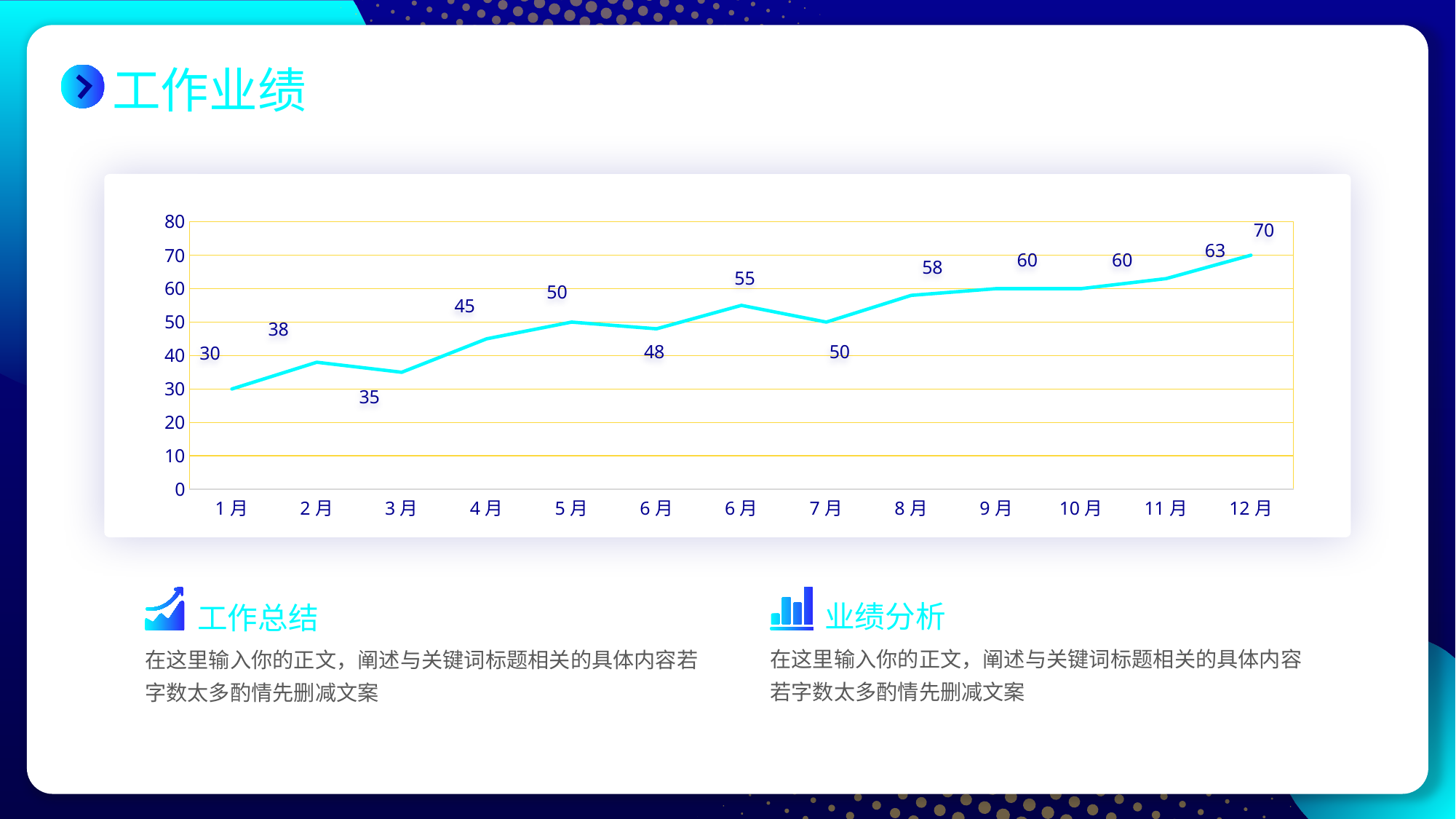
What is the value for 8月? 58 What is the value for 12月? 70 What kind of chart is shown on the slide? line chart What is the value for 1月? 30 Which month has the lowest value? 1月 Do the values generally rise or fall from 1月 to 12月? rise How many data points are plotted on the line? 13 What is the difference between the values for 12月 and 1月? 40 What is the value for 11月? 63 Which month has the highest value? 12月 What is the value for 4月? 45 Which is larger, the value for 2月 or the value for 3月? 2月